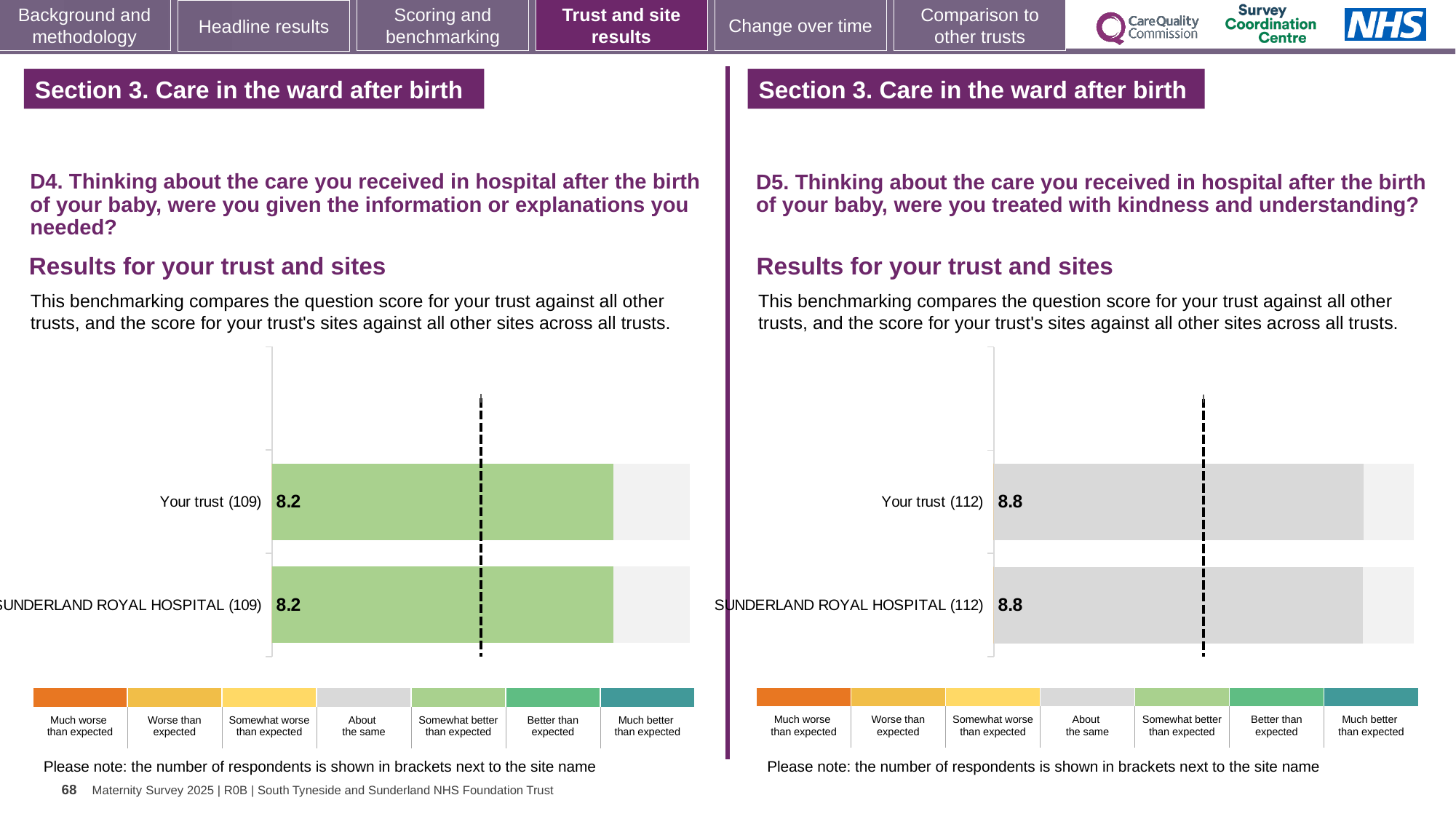
How many bars are plotted in the left chart (D4)? 2 What kind of chart is used in the left chart (D4)? Bar chart In the left chart (D4), how many respondents are shown in brackets for Your trust? 109 In the right chart (D5), what is the score for Your trust? 8.8 In the left chart (D4), what is the score for SUNDERLAND ROYAL HOSPITAL? 8.2 In the right chart (D5), how many respondents are shown in brackets for SUNDERLAND ROYAL HOSPITAL? 112 In the left chart (D4), what is the difference between the score for Your trust and the score for SUNDERLAND ROYAL HOSPITAL? 0 In the left chart (D4), what is the score for Your trust? 8.2 How many bars are plotted in the right chart (D5)? 2 According to the colour key, which benchmarking category do the bars in the right chart (D5) fall into? About the same In the right chart (D5), what is the difference between the score for Your trust and the score for SUNDERLAND ROYAL HOSPITAL? 0 In the right chart (D5), what is the score for SUNDERLAND ROYAL HOSPITAL? 8.8